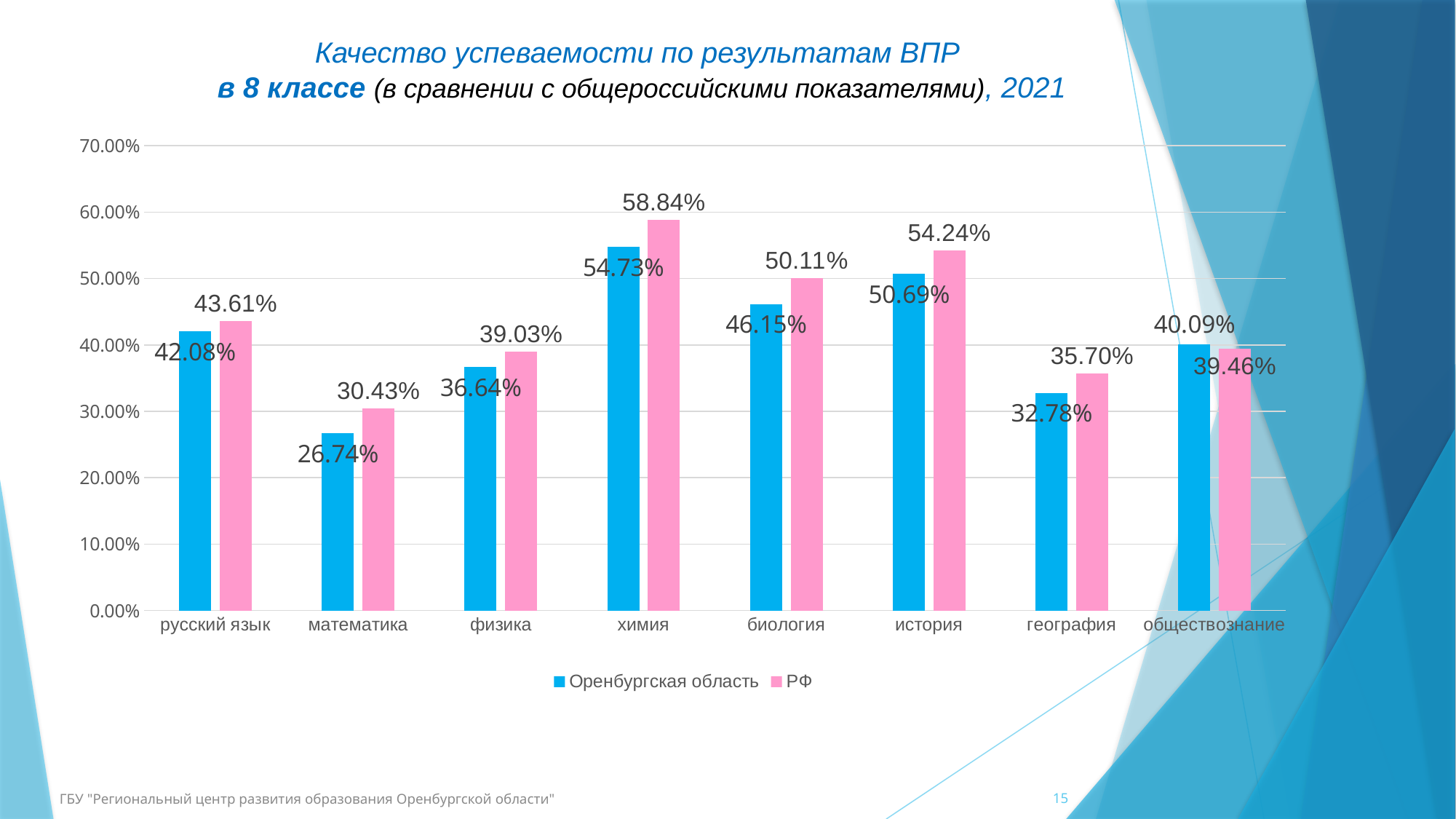
How many subjects are shown on the x axis? 8 What is the value for Оренбургская область in химия? 54.73% Which colour represents РФ in the chart? pink Which subject has the lowest value for Оренбургская область? математика Which is larger in обществознание: the value for Оренбургская область or for РФ? Оренбургская область Which subject has the highest value for РФ? химия Is the value for Оренбургская область in география greater or less than 40.00%? less How many series does the legend list? 2 What is the value for Оренбургская область in обществознание? 40.09% What kind of chart is shown on the slide? bar chart What is the value for РФ in математика? 30.43% What is the difference between the РФ and Оренбургская область values for история? 3.55%